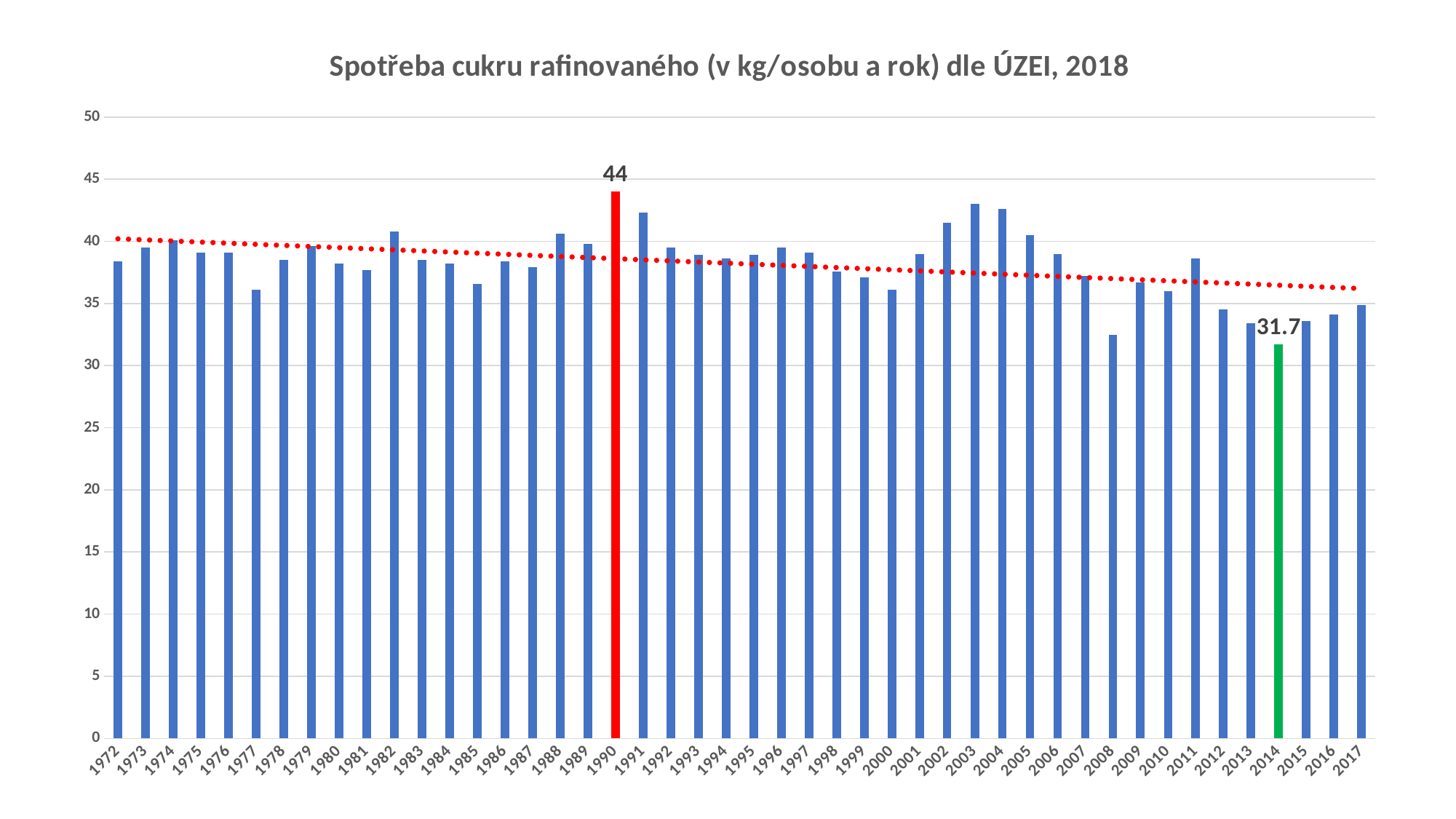
What is the difference between the values for 1990 and 2014? 12.3 What kind of chart is this? bar chart Does the dotted trend line rise or fall from 1972 to 2017? fall What is the value for 1990? 44 How many years are shown on the x axis? 46 What is the value for 2014? 31.7 Which year has the lowest value? 2014 Is the value for 1991 greater or less than 40? greater Which year has the highest value? 1990 Is the value for 1977 greater or less than 40? less Is the value for 2008 greater or less than 35? less Which is larger, the value for 2003 or the value for 2008? 2003